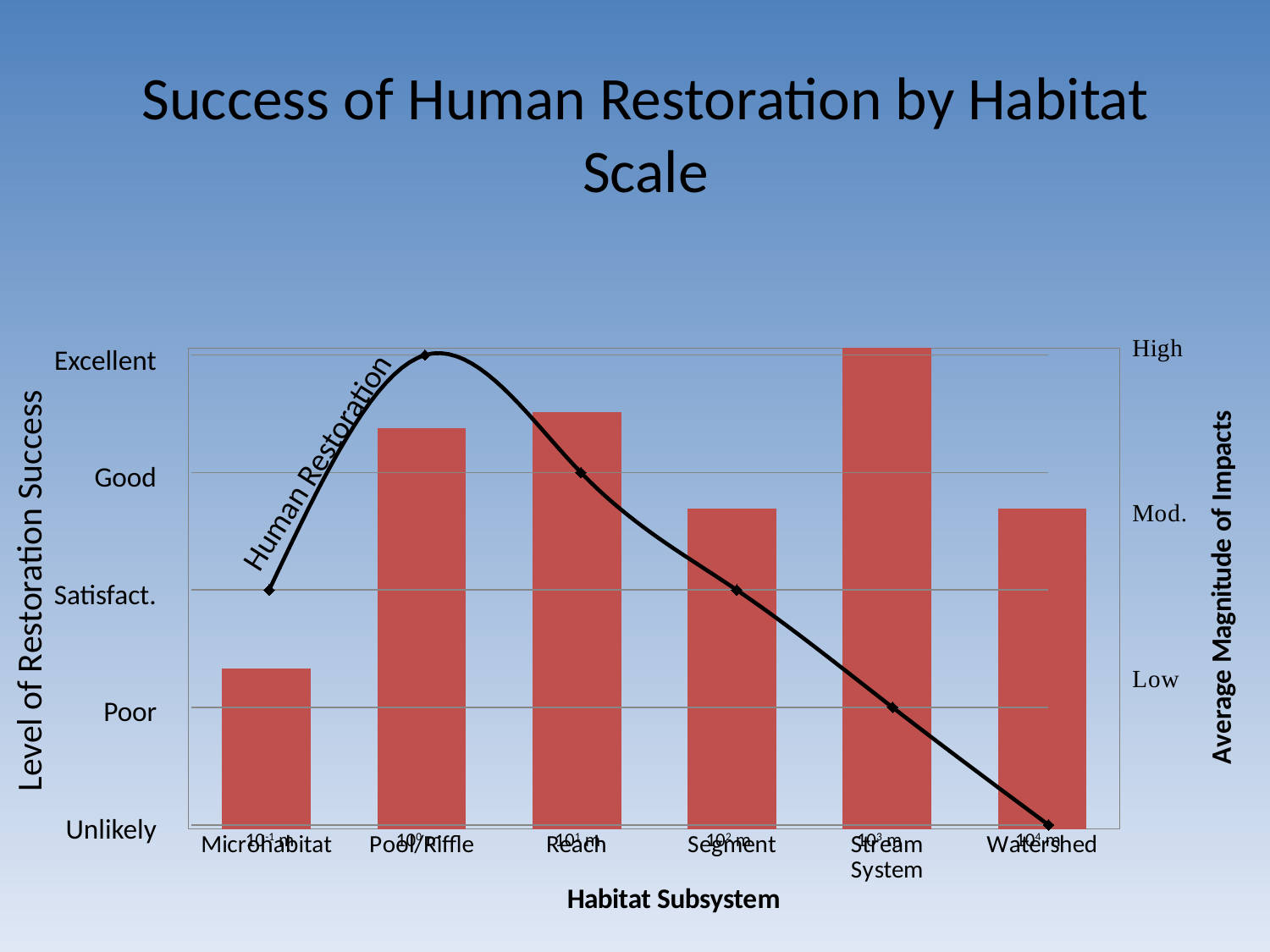
How does the Human Restoration line change from Pool/Riffle to Watershed? It falls Which habitat subsystem has the lowest bar for Average Magnitude of Impacts? Microhabitat What level of restoration success does the Human Restoration line show for Watershed? Unlikely What level of restoration success does the Human Restoration line show for Reach? Good Which has the larger Average Magnitude of Impacts bar, Microhabitat or Segment? Segment What is the title of the chart? Success of Human Restoration by Habitat Scale What kind of chart is shown on the slide? A bar chart with a line overlaid What level of restoration success does the Human Restoration line show for Pool/Riffle? Excellent What level of restoration success does the Human Restoration line show for Stream System? Poor Which habitat subsystem has the highest bar for Average Magnitude of Impacts? Stream System How many habitat subsystem categories are shown on the x axis? 6 What is the label of the x axis? Habitat Subsystem